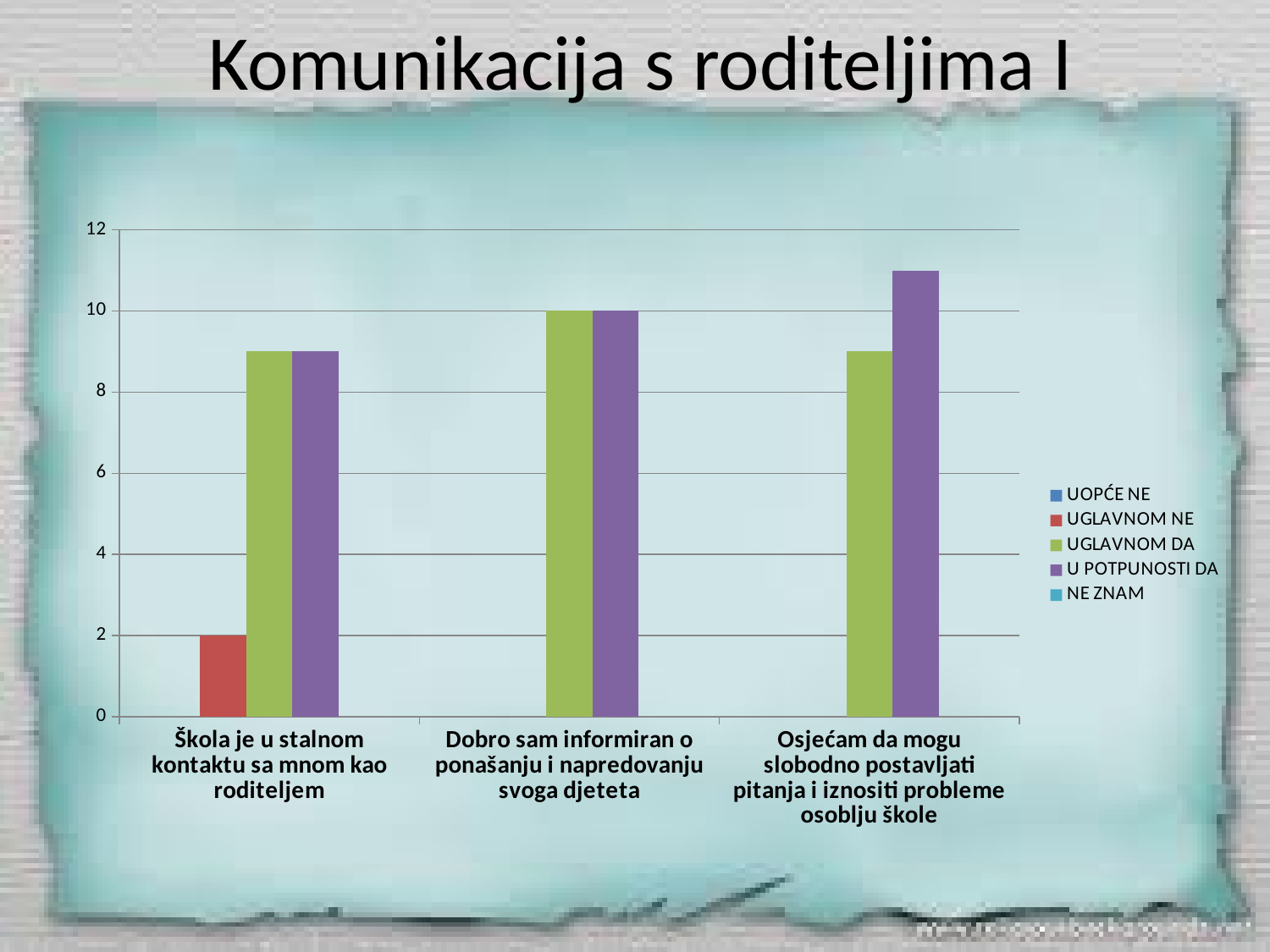
What is the title of the slide? Komunikacija s roditeljima I Which category is the only one with a visible UGLAVNOM NE bar? Škola je u stalnom kontaktu sa mnom kao roditeljem Which category has the highest U POTPUNOSTI DA bar? Osjećam da mogu slobodno postavljati pitanja i iznositi probleme osoblju škole What is the value of UGLAVNOM NE for "Škola je u stalnom kontaktu sa mnom kao roditeljem"? 2 What is the value of UGLAVNOM DA for "Dobro sam informiran o ponašanju i napredovanju svoga djeteta"? 10 Is the value of UGLAVNOM DA for "Škola je u stalnom kontaktu sa mnom kao roditeljem" greater or less than 8? greater How many series does the legend list? 5 What kind of chart is shown on the slide? bar chart What is the value of U POTPUNOSTI DA for "Dobro sam informiran o ponašanju i napredovanju svoga djeteta"? 10 For "Osjećam da mogu slobodno postavljati pitanja i iznositi probleme osoblju škole", which is larger: UGLAVNOM DA or U POTPUNOSTI DA? U POTPUNOSTI DA How many categories are shown on the x axis? 3 Is the value of U POTPUNOSTI DA for "Osjećam da mogu slobodno postavljati pitanja i iznositi probleme osoblju škole" greater or less than 10? greater